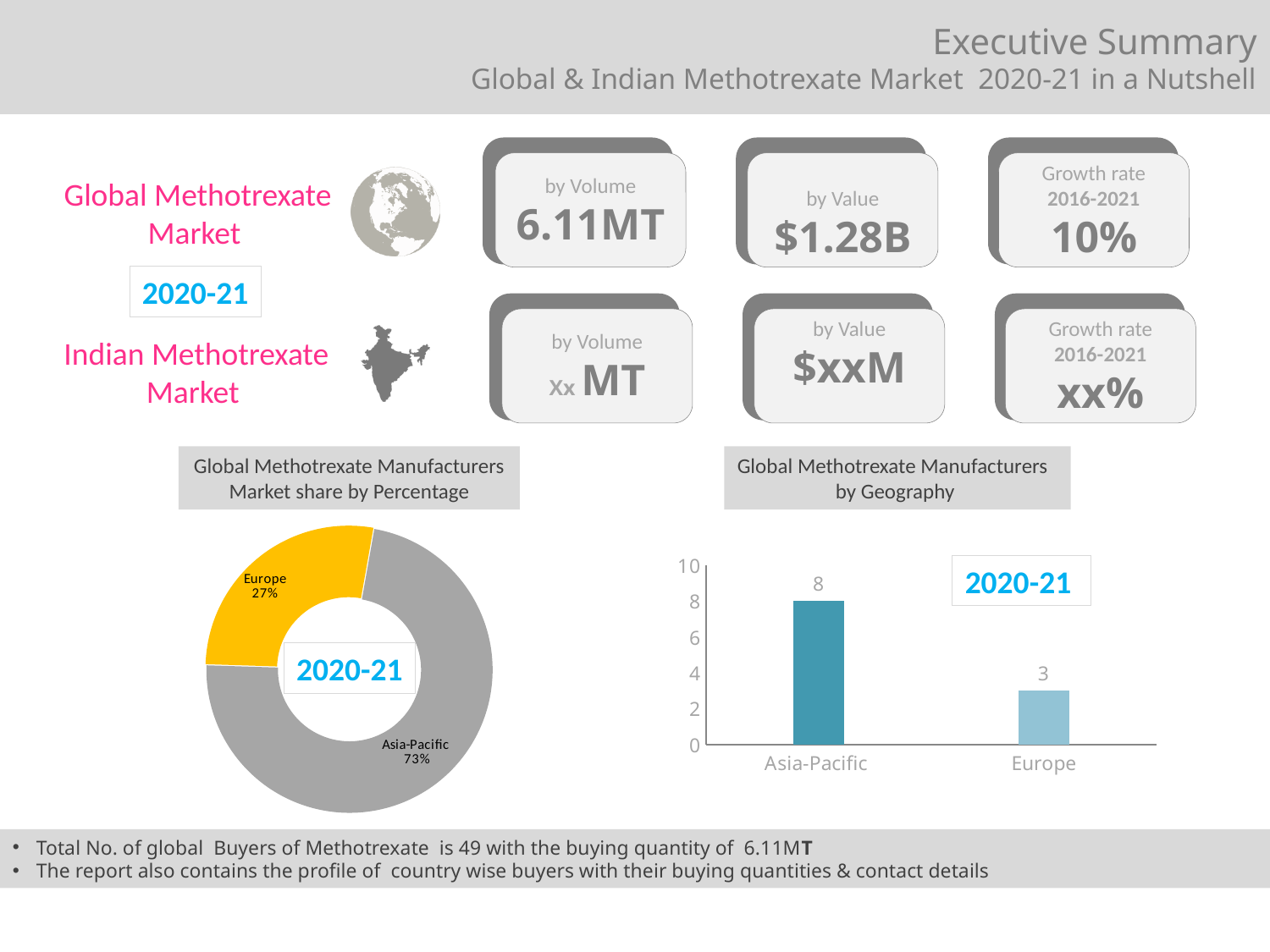
In the 'Global Methotrexate Manufacturers Market share by Percentage' chart, which region has the largest share? Asia-Pacific In the 'Global Methotrexate Manufacturers by Geography' chart, what is the difference between Asia-Pacific and Europe? 5 In the 'Global Methotrexate Manufacturers by Geography' chart, is the value for Europe greater or less than 4? less In the 'Global Methotrexate Manufacturers Market share by Percentage' chart, what is the difference in percentage points between Asia-Pacific and Europe? 46 In the 'Global Methotrexate Manufacturers by Geography' chart, what is the value for Asia-Pacific? 8 What kind of chart is the 'Global Methotrexate Manufacturers by Geography' chart? Bar chart In the 'Global Methotrexate Manufacturers Market share by Percentage' chart, what is the share for Asia-Pacific? 73% What kind of chart is the 'Global Methotrexate Manufacturers Market share by Percentage' chart? Doughnut (pie) chart In the 'Global Methotrexate Manufacturers Market share by Percentage' chart, what is the share for Europe? 27% In the 'Global Methotrexate Manufacturers by Geography' chart, which region has the lowest value? Europe How many slices does the 'Global Methotrexate Manufacturers Market share by Percentage' chart have? 2 In the 'Global Methotrexate Manufacturers by Geography' chart, what is the value for Europe? 3